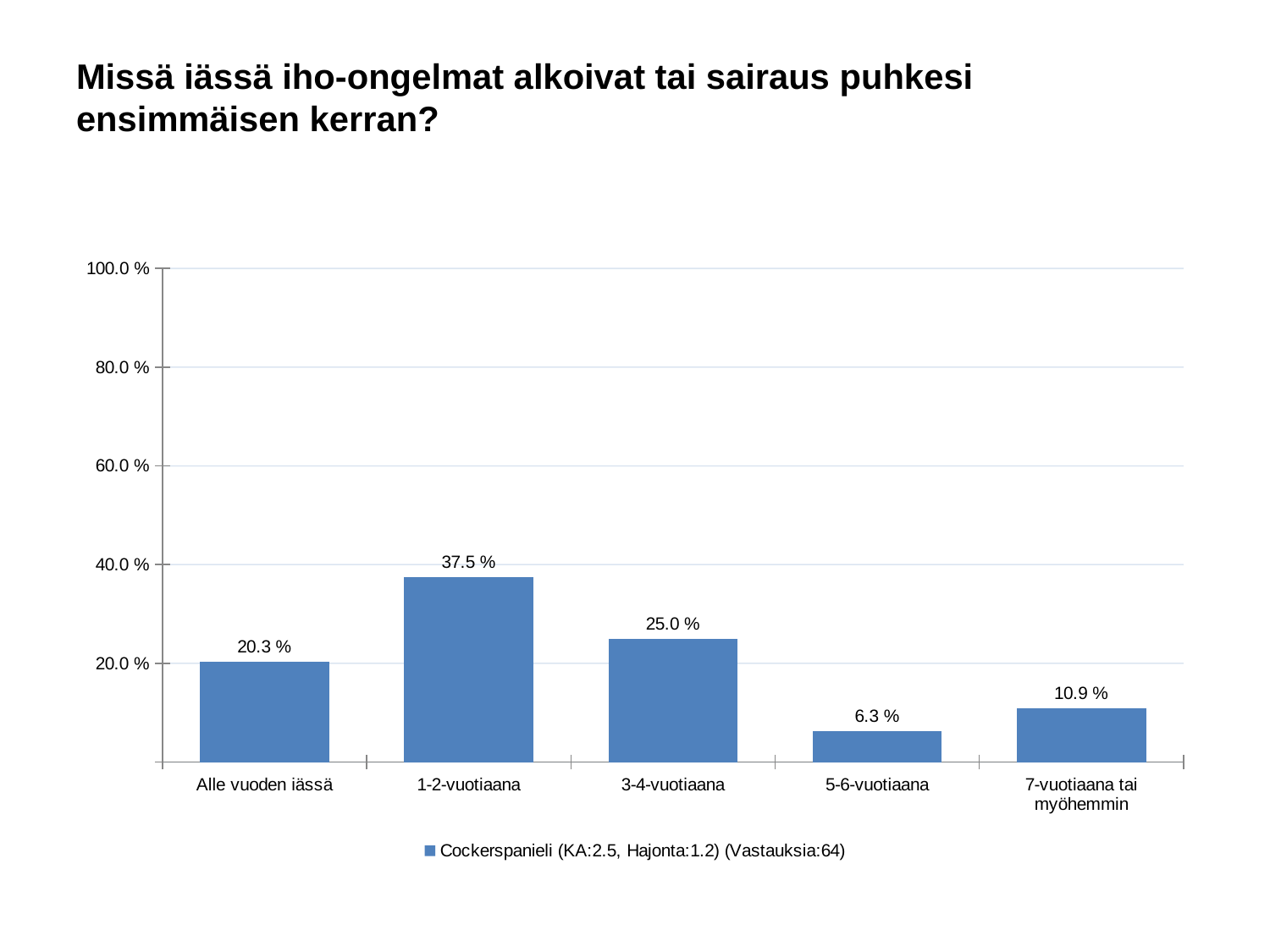
What is the value for "7-vuotiaana tai myöhemmin"? 10.9 % What kind of chart is shown on the slide? bar chart How many categories are shown on the x axis? 5 What is the difference between the values for "1-2-vuotiaana" and "3-4-vuotiaana"? 12.5 % Which category has the highest value? 1-2-vuotiaana Is the value for "3-4-vuotiaana" greater or less than 40.0 %? less How many series does the legend list? 1 What is the value for "Alle vuoden iässä"? 20.3 % Which category has the lowest value? 5-6-vuotiaana Which is larger, the value for "Alle vuoden iässä" or the value for "7-vuotiaana tai myöhemmin"? Alle vuoden iässä How many responses (Vastauksia) does the legend entry report? 64 What is the value for "1-2-vuotiaana"? 37.5 %